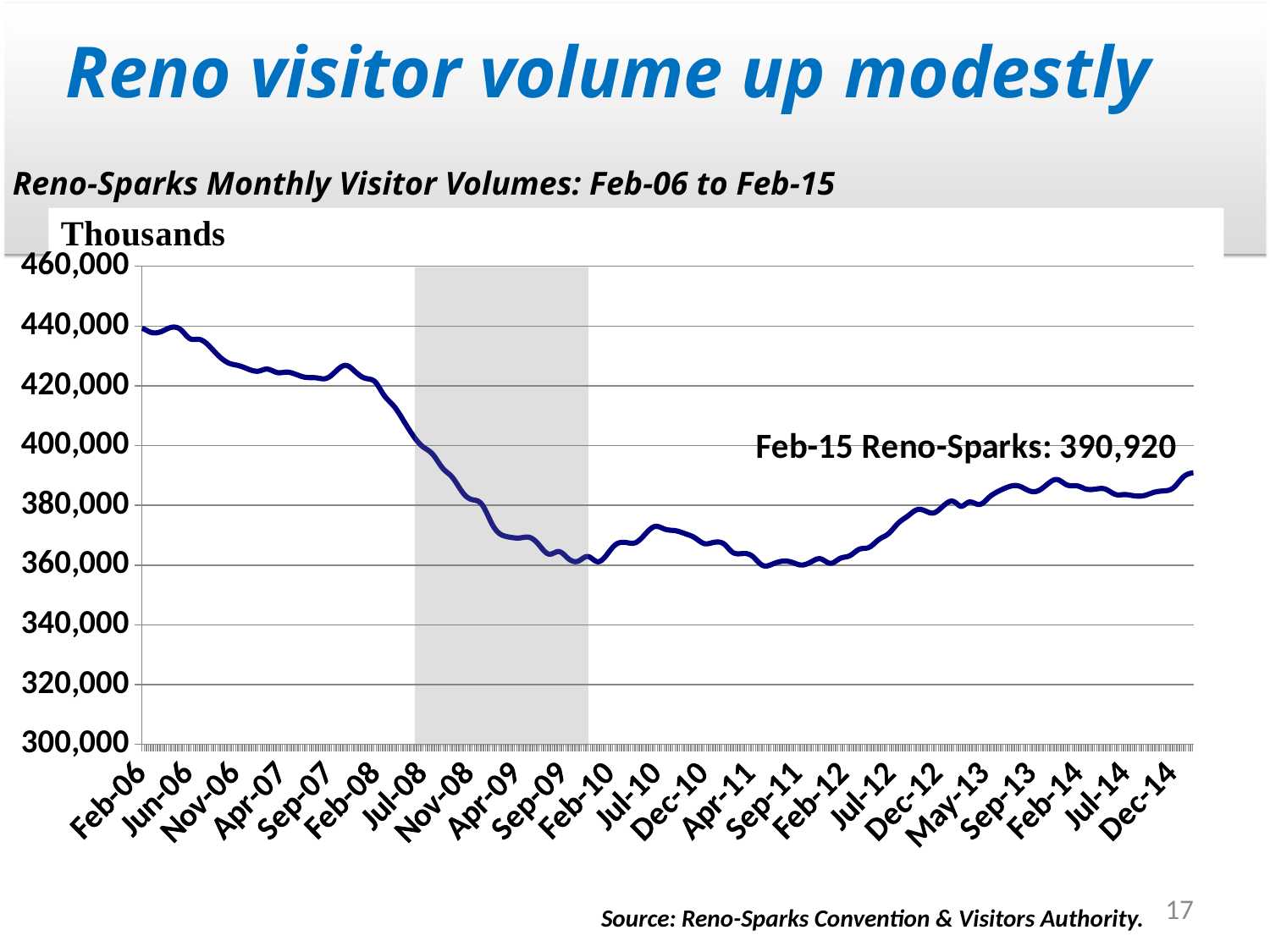
What kind of chart is shown on the slide? line chart Is the value for Feb-10 greater or less than 380,000? less What is the Reno-Sparks visitor volume for Feb-15 as labeled on the chart? 390,920 What unit label is shown at the top of the vertical axis? Thousands Is the value for Sep-11 greater or less than 380,000? less Which is larger, the visitor volume for Feb-10 or for Feb-14? Feb-14 Is the value for Apr-09 greater or less than 380,000? less Which is larger, the visitor volume for Feb-06 or for Feb-15? Feb-06 What is the title of the chart? Reno-Sparks Monthly Visitor Volumes: Feb-06 to Feb-15 Do visitor volumes rise or fall from Feb-06 to Feb-10? fall